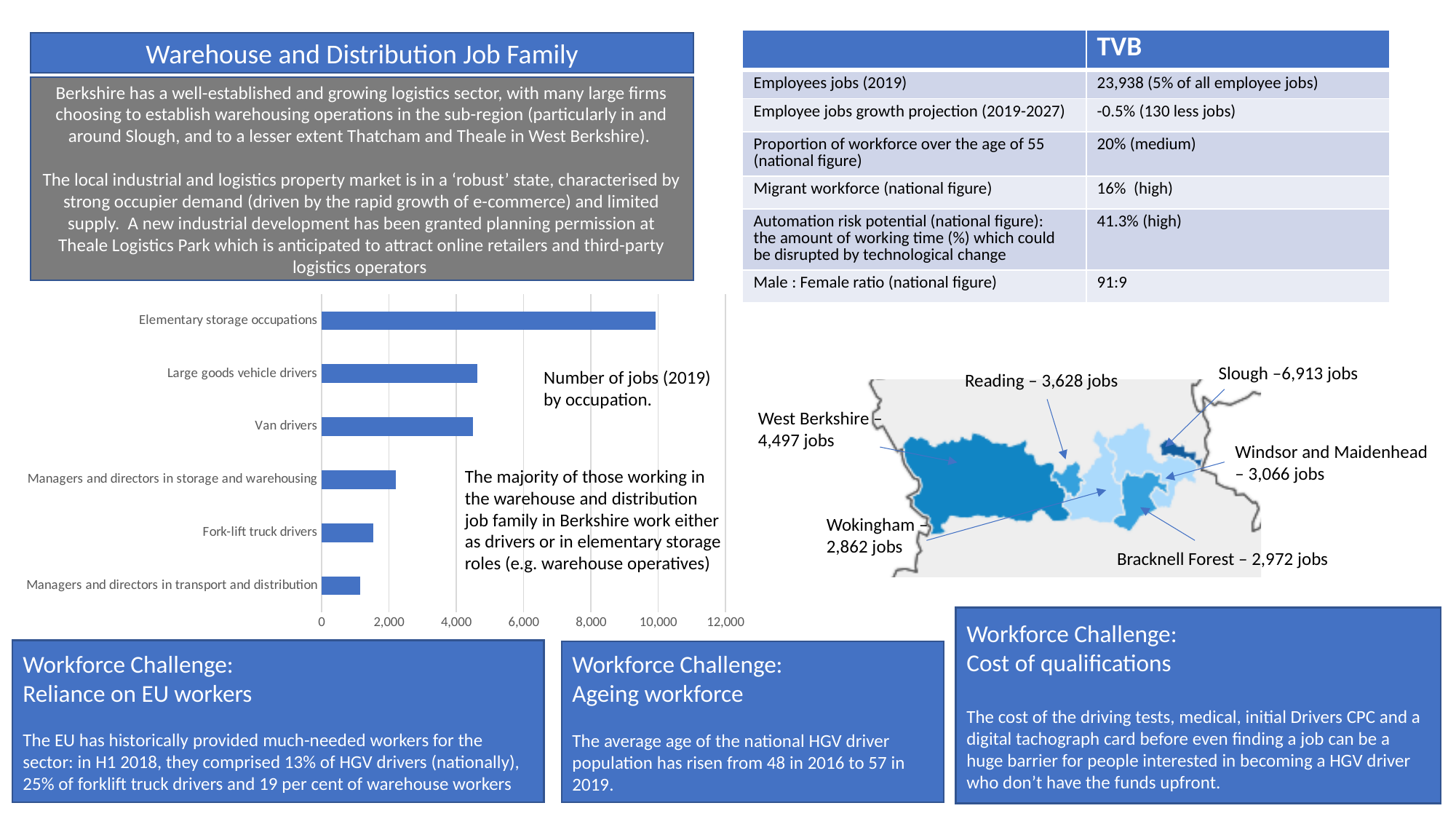
Is the value for Fork-lift truck drivers greater or less than 2,000? less Is the value for Large goods vehicle drivers greater or less than 4,000? greater Which has more jobs: Managers and directors in storage and warehousing or Fork-lift truck drivers? Managers and directors in storage and warehousing Which occupation has the highest number of jobs in the bar chart? Elementary storage occupations Is the value for Elementary storage occupations greater or less than 8,000? greater Which has more jobs: Elementary storage occupations or Large goods vehicle drivers? Elementary storage occupations How many occupations are shown in the bar chart? 6 What is the title of the bar chart? Number of jobs (2019) by occupation. Which occupation has the lowest number of jobs in the bar chart? Managers and directors in transport and distribution What kind of chart is used to show the number of jobs (2019) by occupation? bar chart